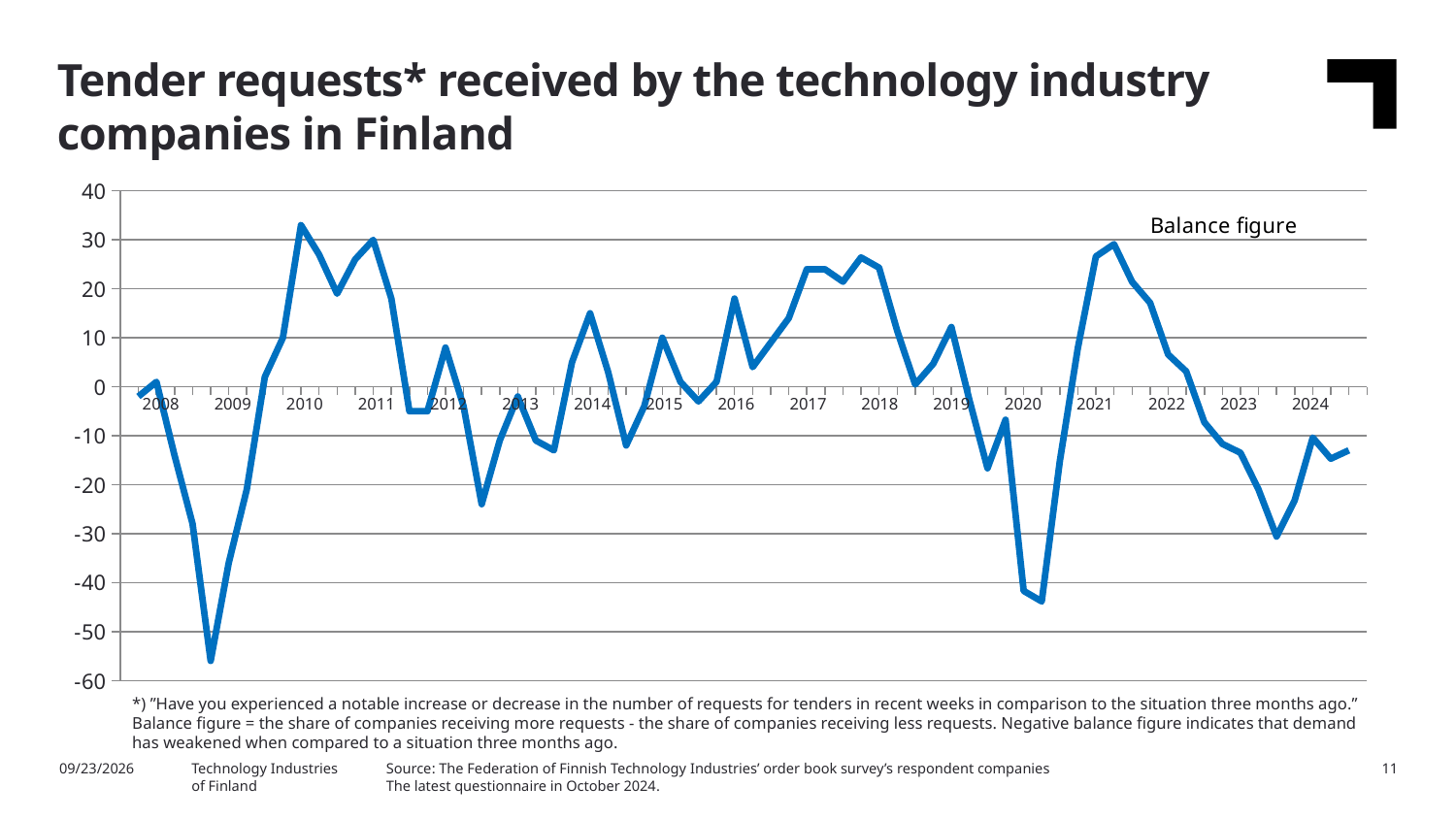
Is the lowest balance figure in 2020 greater or less than -40? less Is the lowest balance figure in 2009 greater or less than -50? less Is the peak balance figure in 2021 greater or less than 20? greater What is the name of the series shown in the chart legend? Balance figure In which year does the balance figure reach its lowest point? 2009 In which year does the balance figure reach its highest point? 2010 How many series does the chart legend list? 1 Does the balance figure rise or fall between its 2021 peak and 2023? fall How many year labels are shown on the x axis? 17 What kind of chart is shown on the slide? line chart